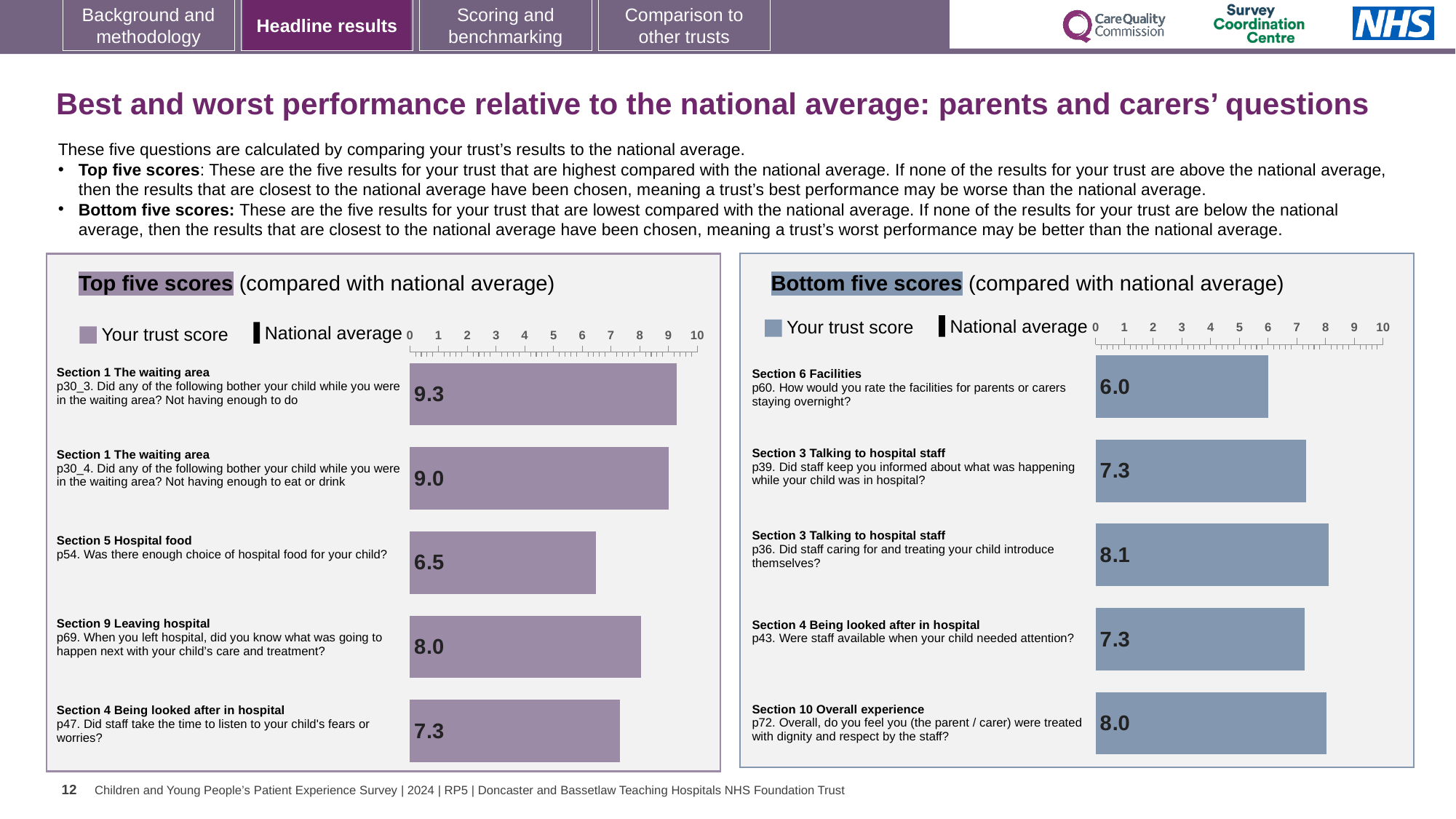
In the Bottom five scores chart, which has the larger trust score: p39 or p72? p72 (8.0) In the Bottom five scores chart, which question has the highest trust score? p36 (Did staff caring for and treating your child introduce themselves?), 8.1 In the Bottom five scores chart, which question has the lowest trust score? p60 (facilities for parents or carers staying overnight), 6.0 What type of chart is used for the Bottom five scores? Bar chart In the Top five scores chart, which question has the lowest trust score? p54 (enough choice of hospital food), 6.5 In the Top five scores chart, what is the difference between the trust score for p30_3 and the trust score for p47? 2.0 In the Bottom five scores chart, what is the trust score for p60 (How would you rate the facilities for parents or carers staying overnight?)? 6.0 How many questions are plotted in the Top five scores chart? 5 In the Top five scores chart, what is the trust score for p54 (Was there enough choice of hospital food for your child?)? 6.5 In the Top five scores chart, which question has the highest trust score? p30_3 (Not having enough to do in the waiting area), 9.3 What two entries does the legend of the Top five scores chart list? Your trust score and National average In the Bottom five scores chart, what is the difference between the highest trust score (p36) and the lowest trust score (p60)? 2.1